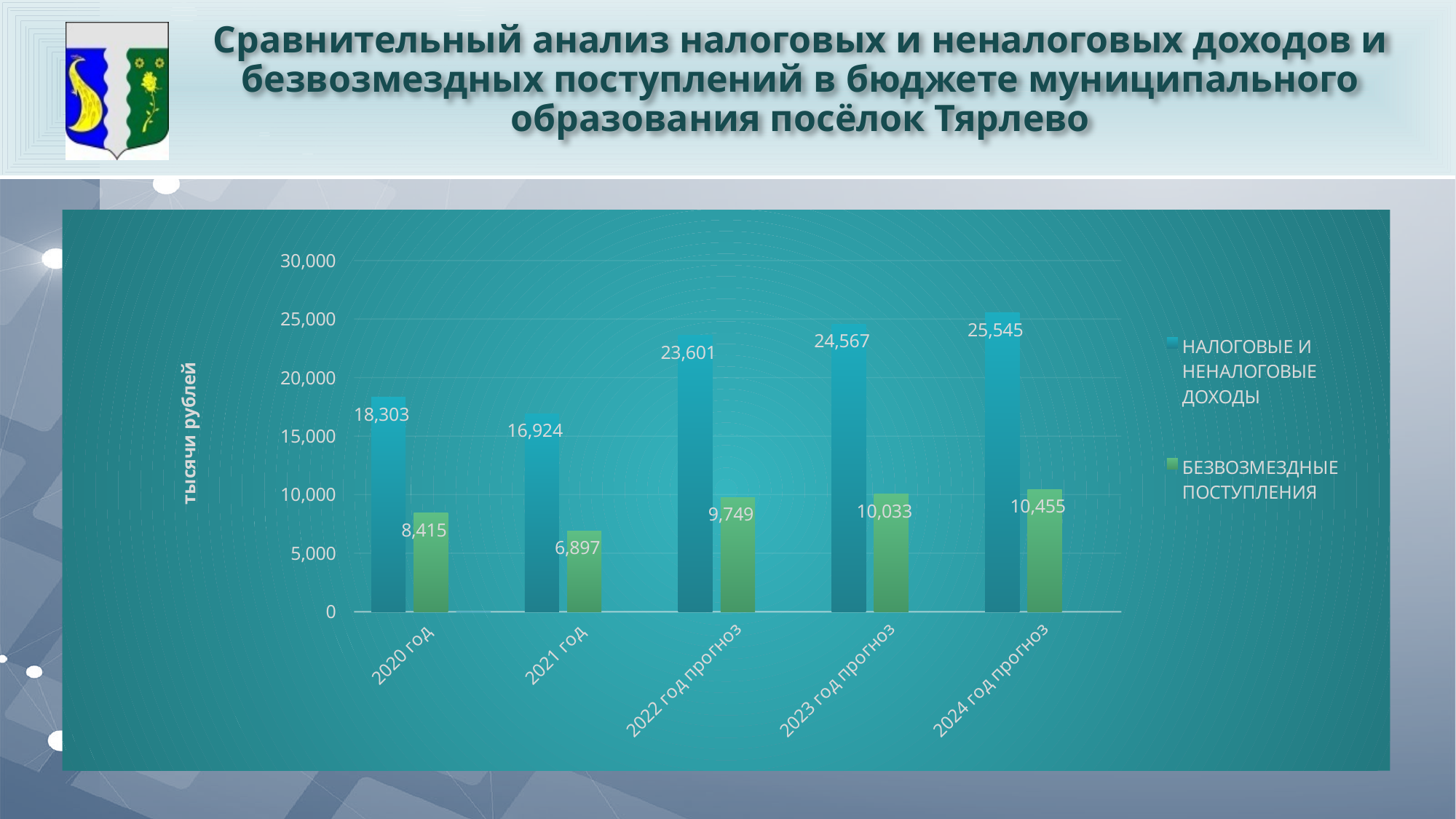
Is the value for БЕЗВОЗМЕЗДНЫЕ ПОСТУПЛЕНИЯ in 2023 год прогноз greater or less than 10,000? greater In which year is the value for БЕЗВОЗМЕЗДНЫЕ ПОСТУПЛЕНИЯ the lowest? 2021 год What is the difference between НАЛОГОВЫЕ И НЕНАЛОГОВЫЕ ДОХОДЫ and БЕЗВОЗМЕЗДНЫЕ ПОСТУПЛЕНИЯ in 2022 год прогноз? 13,852 What kind of chart is shown on the slide? bar chart What is the value for БЕЗВОЗМЕЗДНЫЕ ПОСТУПЛЕНИЯ in 2021 год? 6,897 What is the value for НАЛОГОВЫЕ И НЕНАЛОГОВЫЕ ДОХОДЫ in 2023 год прогноз? 24,567 What is the value for БЕЗВОЗМЕЗДНЫЕ ПОСТУПЛЕНИЯ in 2024 год прогноз? 10,455 Which is larger: НАЛОГОВЫЕ И НЕНАЛОГОВЫЕ ДОХОДЫ in 2020 год or in 2021 год? 2020 год How many series does the legend list? 2 What is the value for НАЛОГОВЫЕ И НЕНАЛОГОВЫЕ ДОХОДЫ in 2020 год? 18,303 In which year is the value for НАЛОГОВЫЕ И НЕНАЛОГОВЫЕ ДОХОДЫ the highest? 2024 год прогноз How many year categories are shown on the x axis? 5